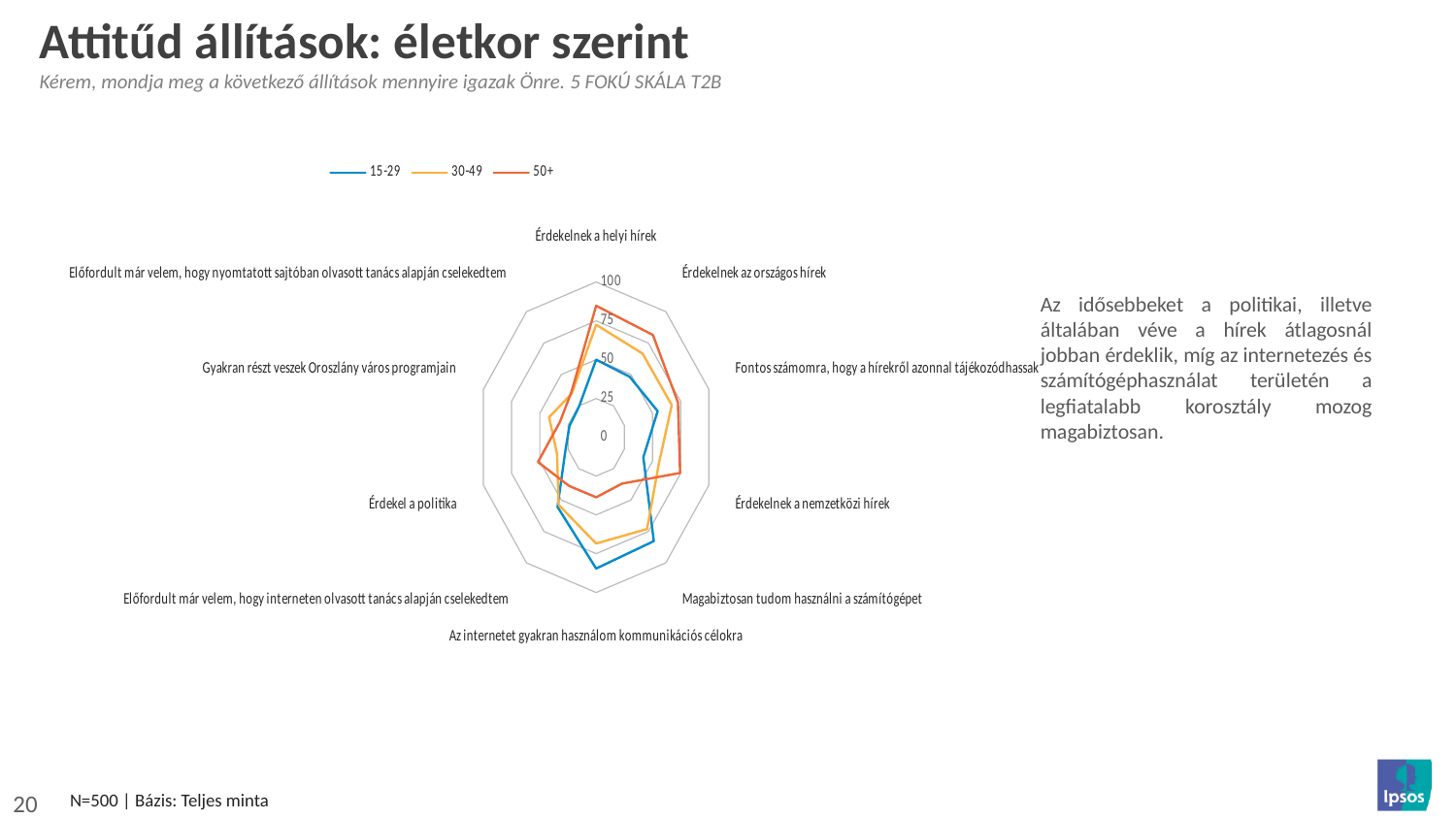
How many statements (categories) are plotted on the radar chart? 10 Which age groups are listed in the legend? 15-29, 30-49, 50+ What kind of chart is shown on the slide? Radar chart For 'Érdekel a politika', which group has the larger value: 15-29 or 50+? 50+ Which age group has the lowest value for 'Magabiztosan tudom használni a számítógépet'? 50+ Which age group has the highest value for 'Érdekelnek a helyi hírek'? 50+ How many series does the legend list? 3 Is the value of the 15-29 group for 'Az internetet gyakran használom kommunikációs célokra' greater or less than 75? greater What is the highest value shown on the radar chart's axis scale? 100 Is the value of the 50+ group for 'Érdekelnek a helyi hírek' greater or less than 75? greater Is the value of the 50+ group for 'Az internetet gyakran használom kommunikációs célokra' greater or less than 50? less